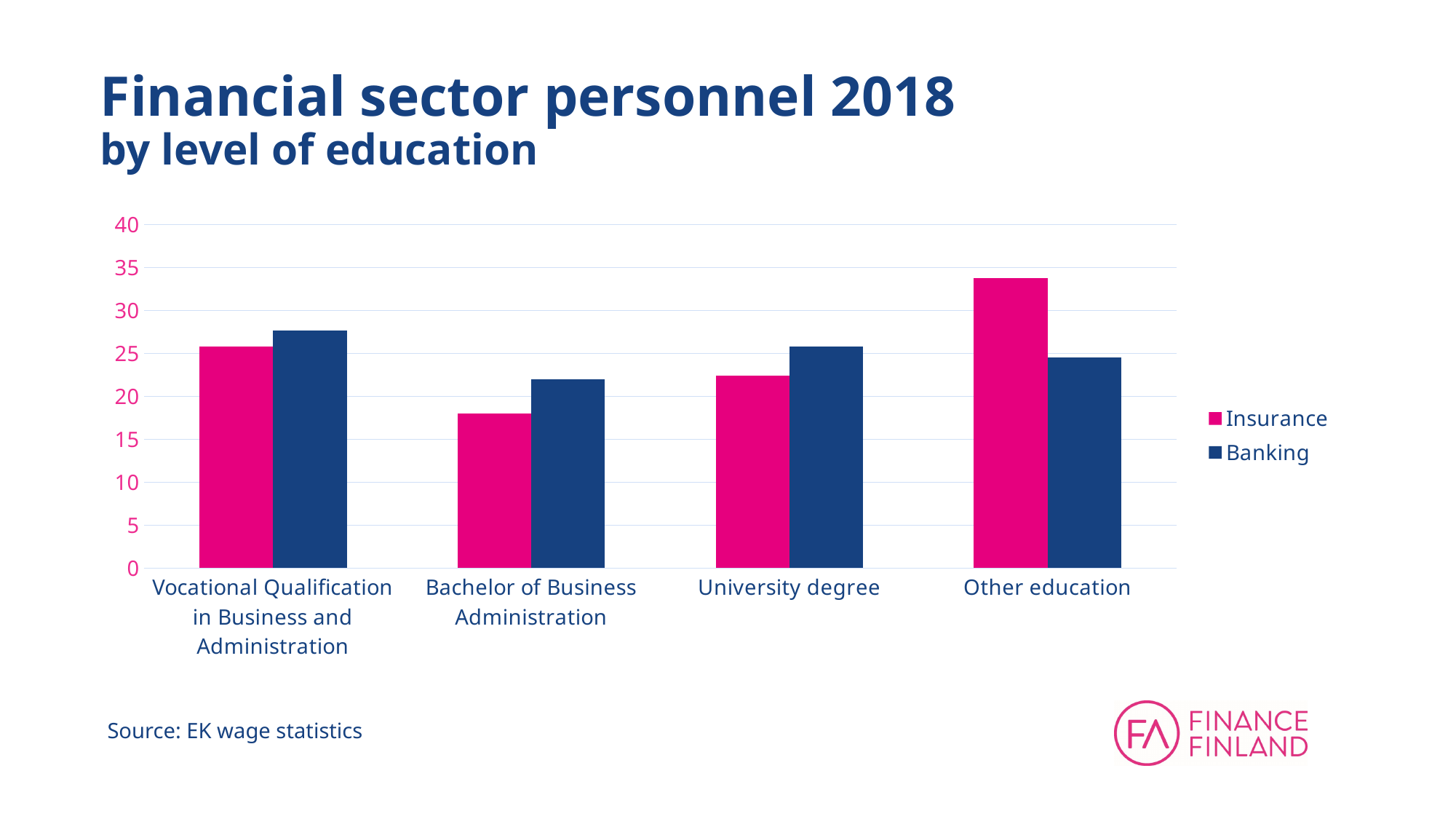
Is the Insurance value for Other education greater or less than 30? greater Which education category has the lowest Banking value? Bachelor of Business Administration Is the Insurance value for Bachelor of Business Administration greater or less than 20? less Which education category has the lowest Insurance value? Bachelor of Business Administration How many education categories are shown on the x axis? 4 How many series does the legend list? 2 What colour are the Insurance bars? pink For Other education, which series has the larger value, Insurance or Banking? Insurance What kind of chart is shown on the slide? bar chart Which education category has the highest Banking value? Vocational Qualification in Business and Administration Which education category has the highest Insurance value? Other education For Bachelor of Business Administration, which series has the larger value, Insurance or Banking? Banking